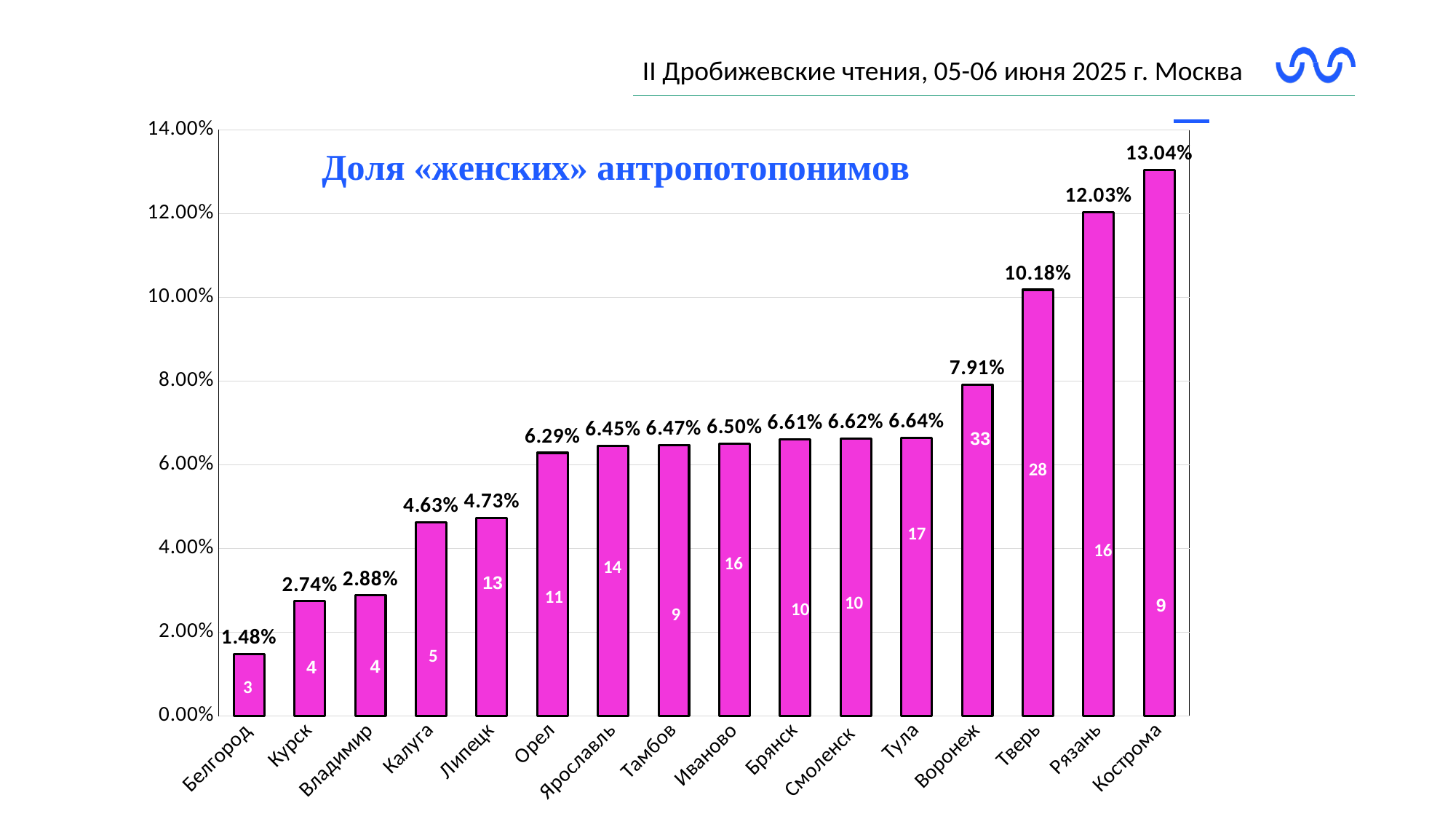
Which city has the highest value? Кострома Is the value for Липецк greater or less than 4.00%? greater What is the difference between the values for Кострома and Рязань? 1.01% What is the value for Воронеж? 7.91% How many cities are shown on the x axis? 16 Do the values rise or fall from left to right along the x axis? rise What is the value for Кострома? 13.04% What number is printed inside the bar for Воронеж? 33 What kind of chart is shown on the slide? bar chart What is the title of the chart? Доля «женских» антропотопонимов Which city has the lowest value? Белгород Which is larger, the value for Тверь or the value for Воронеж? Тверь